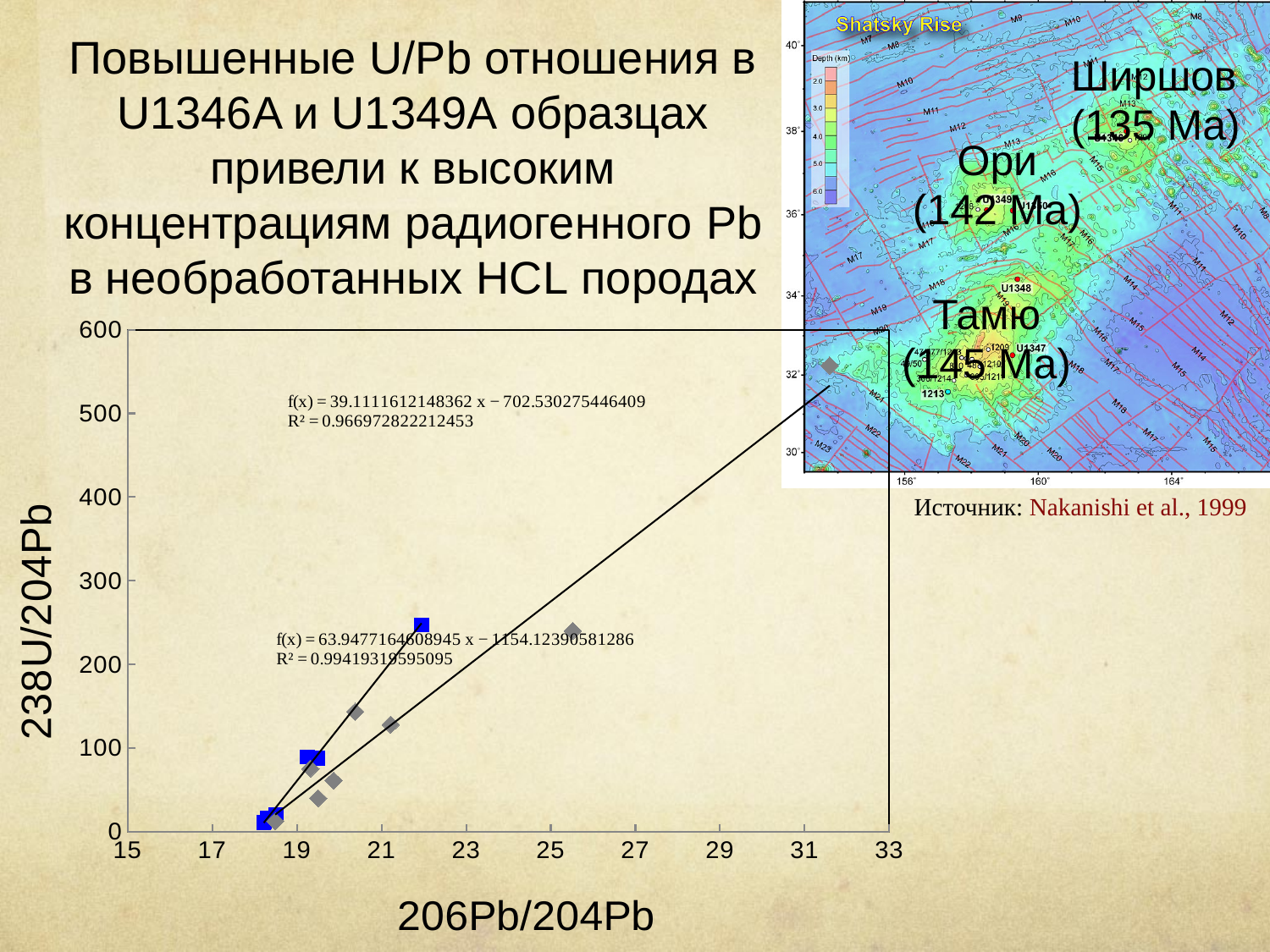
What is the label of the y axis of the chart? 238U/204Pb Do the 238U/204Pb values rise or fall as 206Pb/204Pb increases along the x axis? rise What is the R² value printed for the upper trendline (the one with slope 39.1111612148362)? 0.966972822212453 What is the slope printed in the equation of the trendline with R² = 0.966972822212453? 39.1111612148362 What kind of chart is shown on the slide? scatter chart What is the intercept printed in the equation of the trendline with R² = 0.99419319595095? −1154.12390581286 Is the 238U/204Pb value of the highest blue square point (near 206Pb/204Pb ≈ 22) greater or less than 200? greater What is the R² value printed for the lower trendline (the one with slope 63.9477164608945)? 0.99419319595095 What is the maximum value shown on the y axis of the chart? 600 What is the label of the x axis of the chart? 206Pb/204Pb Is the 238U/204Pb value of the rightmost gray diamond point (near 206Pb/204Pb ≈ 31.5) greater or less than 500? greater Which series contains the point with the highest 238U/204Pb value, the blue squares or the gray diamonds? gray diamonds